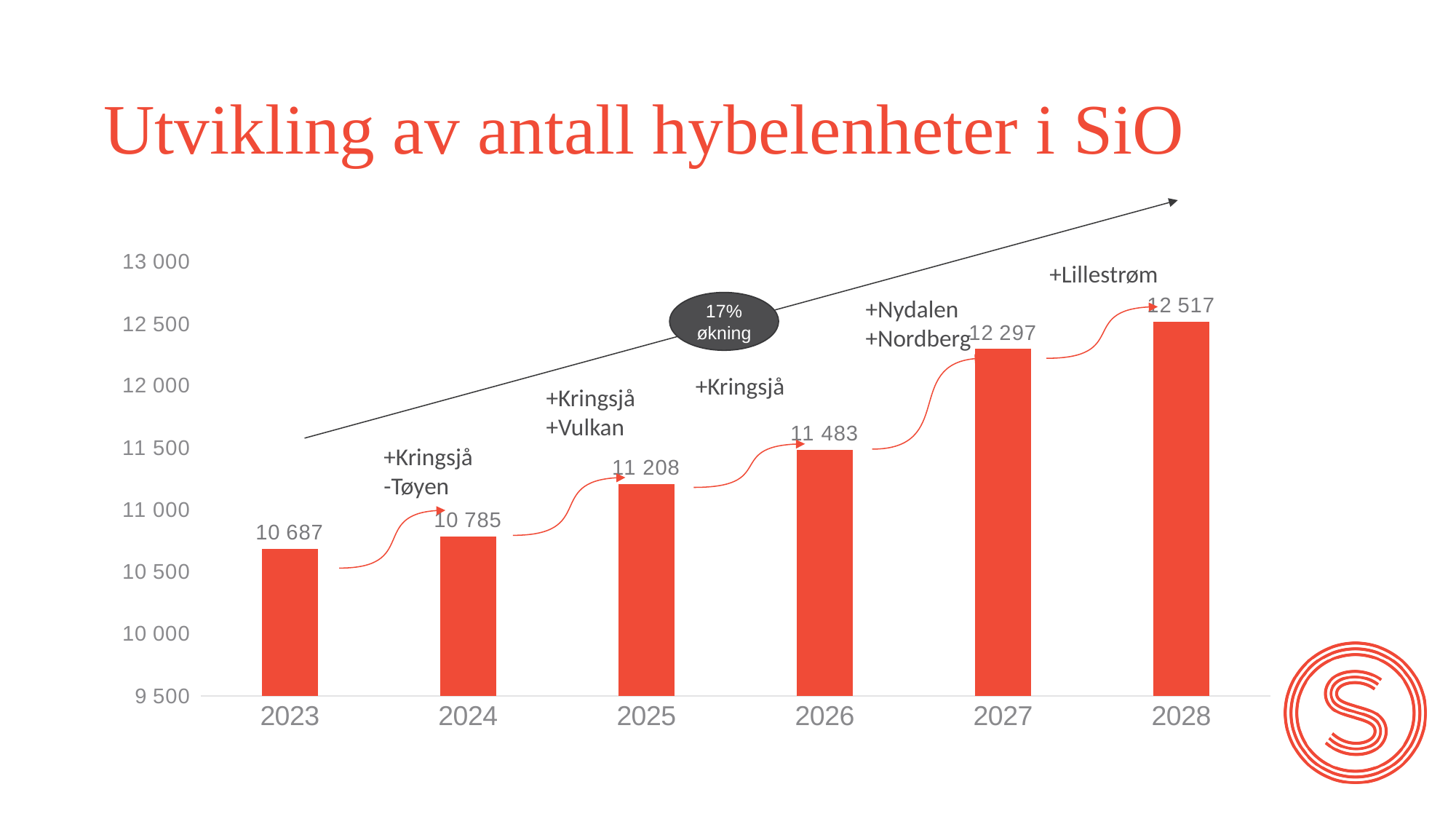
What is the difference between the values for 2028 and 2023? 1 830 What is the value for 2028? 12 517 What kind of chart is shown? bar chart How many years are shown on the x axis? 6 What is the difference between the values for 2025 and 2024? 423 Do the values rise or fall from 2023 to 2028? rise What is the value for 2026? 11 483 Which is larger, the value for 2027 or the value for 2026? 2027 Which year has the highest value? 2028 Which year has the lowest value? 2023 Is the value for 2025 greater or less than 11 000? greater What is the value for 2023? 10 687